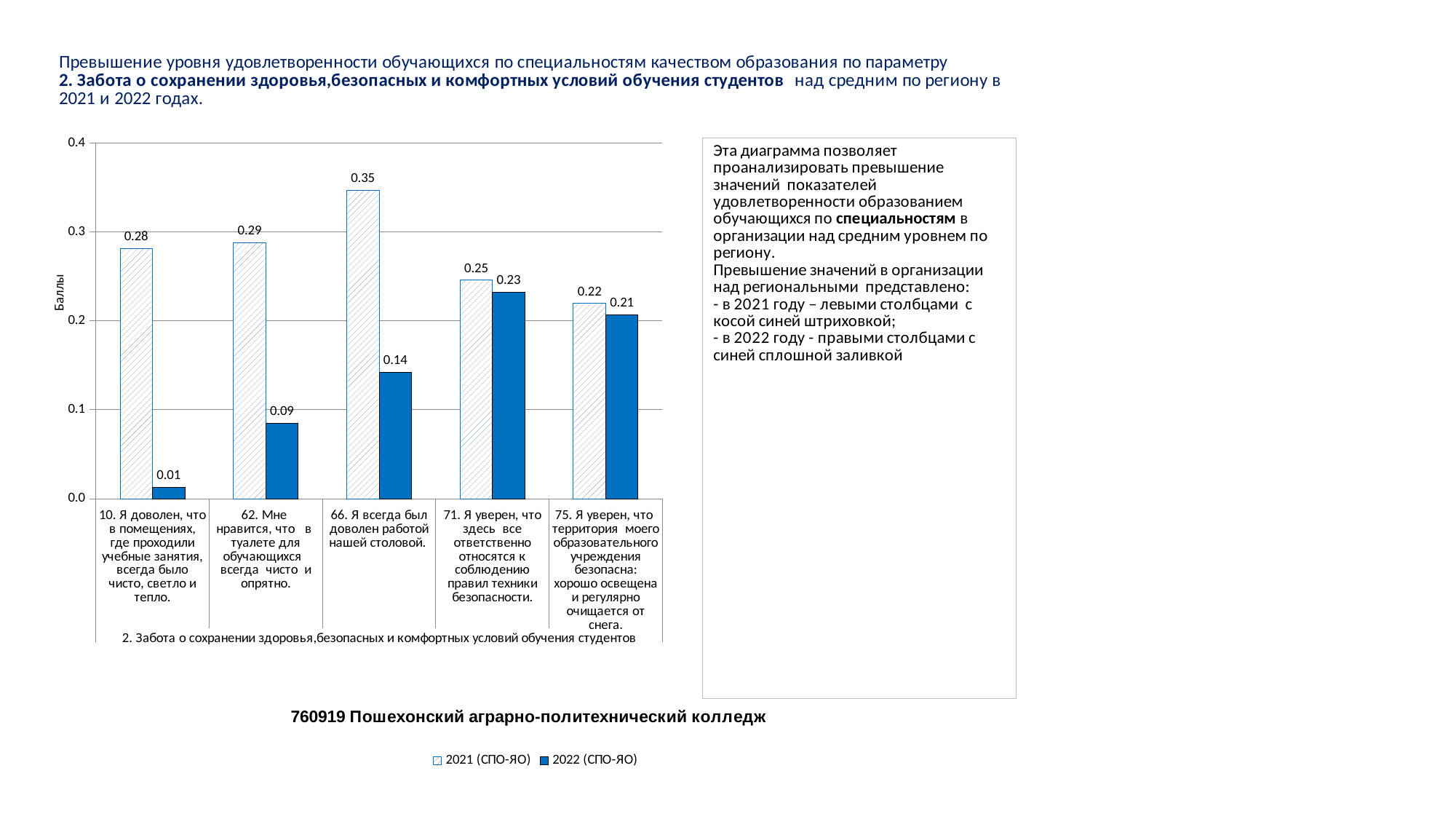
Which question has the lowest 2022 (СПО-ЯО) value? 10. Я доволен, что в помещениях, где проходили учебные занятия, всегда было чисто, светло и тепло. What is the difference between the 2021 and 2022 values for question 66? 0.21 Which is larger for question 71: the 2021 (СПО-ЯО) value or the 2022 (СПО-ЯО) value? 2021 (СПО-ЯО) How many series does the legend list? 2 What kind of chart is shown on the slide? bar chart How many question categories are shown on the x axis? 5 What is the 2021 (СПО-ЯО) value for question 66 ("Я всегда был доволен работой нашей столовой")? 0.35 What is the 2022 (СПО-ЯО) value for question 10 ("Я доволен, что в помещениях, где проходили учебные занятия, всегда было чисто, светло и тепло")? 0.01 What is the label of the vertical axis? Баллы Is the 2021 (СПО-ЯО) value for question 66 greater or less than 0.3? greater What is the 2022 (СПО-ЯО) value for question 62 ("Мне нравится, что в туалете для обучающихся всегда чисто и опрятно")? 0.09 Which question has the highest 2021 (СПО-ЯО) value? 66. Я всегда был доволен работой нашей столовой.